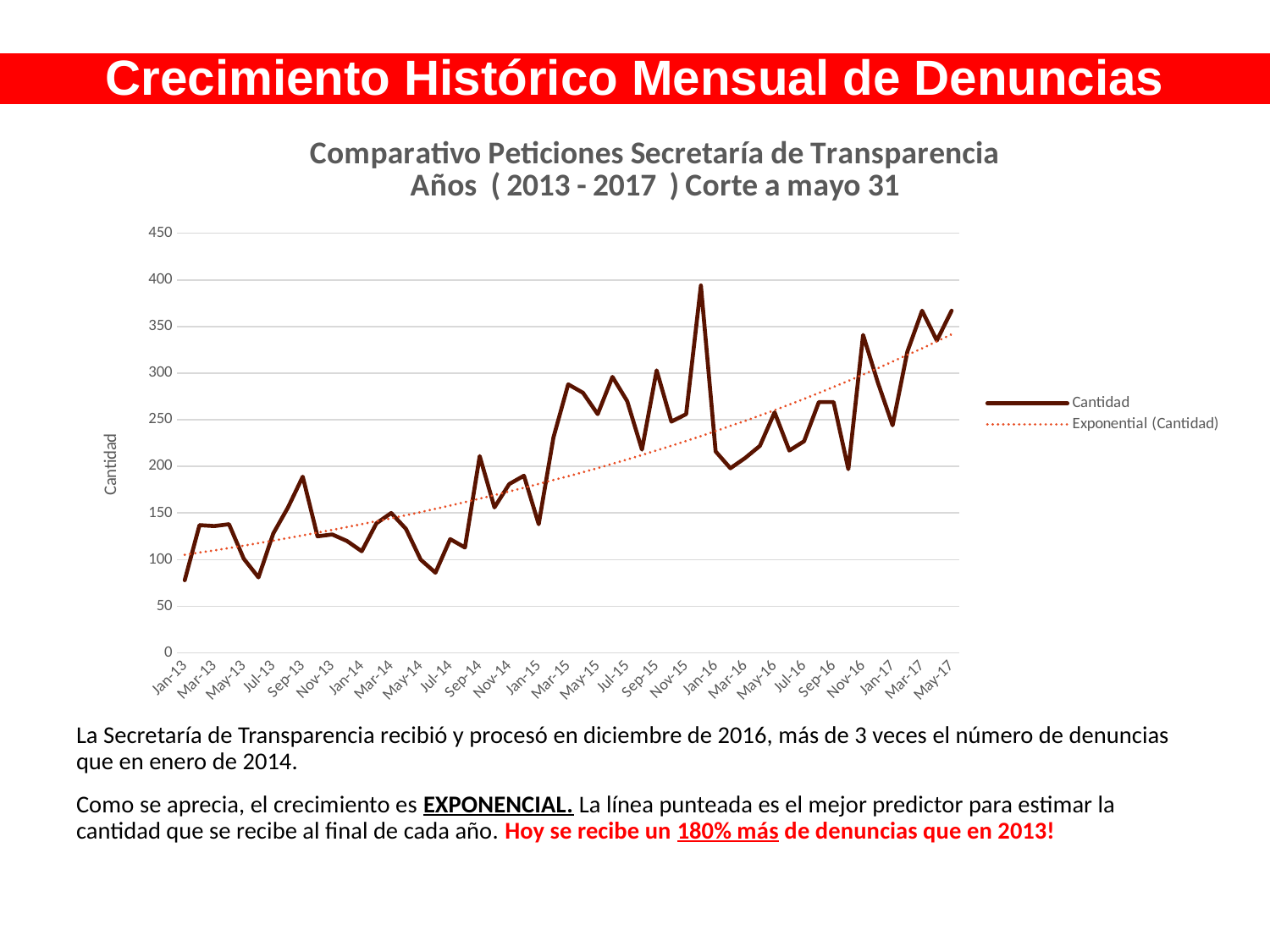
Is the Cantidad value for Jan-13 greater or less than 100? less Is the Cantidad value for Sep-13 greater or less than 150? greater What kind of chart is shown on the slide? line chart What is the title of the chart? Comparativo Peticiones Secretaría de Transparencia Años ( 2013 - 2017 ) Corte a mayo 31 Is the Cantidad value for Jul-14 greater or less than 100? greater At which month does the Cantidad line reach its highest value? Dec-15 How many series does the chart legend list? 2 Overall, do the Cantidad values rise or fall from Jan-13 to May-17? rise What are the two entries in the chart legend? Cantidad and Exponential (Cantidad)